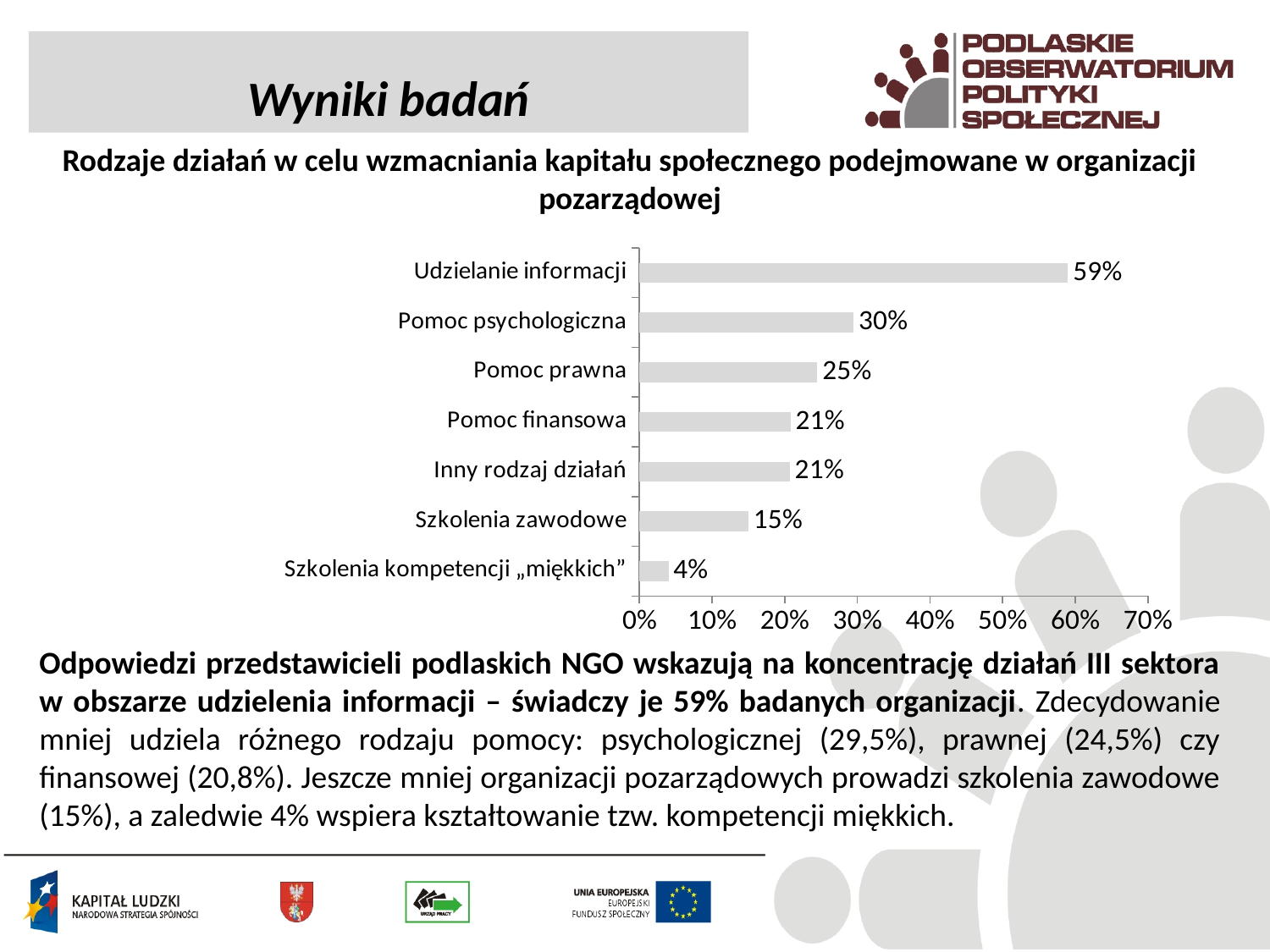
Which category has the highest value? Udzielanie informacji What is the maximum value shown on the horizontal axis? 70% What is the value for Pomoc psychologiczna? 30% Which is larger, the value for Pomoc prawna or the value for Pomoc finansowa? Pomoc prawna What is the value for Udzielanie informacji? 59% How many categories are shown in the chart? 7 Which category has the lowest value? Szkolenia kompetencji „miękkich” What is the difference between the values for Pomoc prawna and Szkolenia zawodowe? 10% What is the value for Szkolenia zawodowe? 15% What kind of chart is shown on the slide? Bar chart What is the difference between the values for Udzielanie informacji and Pomoc psychologiczna? 29% What is the value for Szkolenia kompetencji „miękkich”? 4%